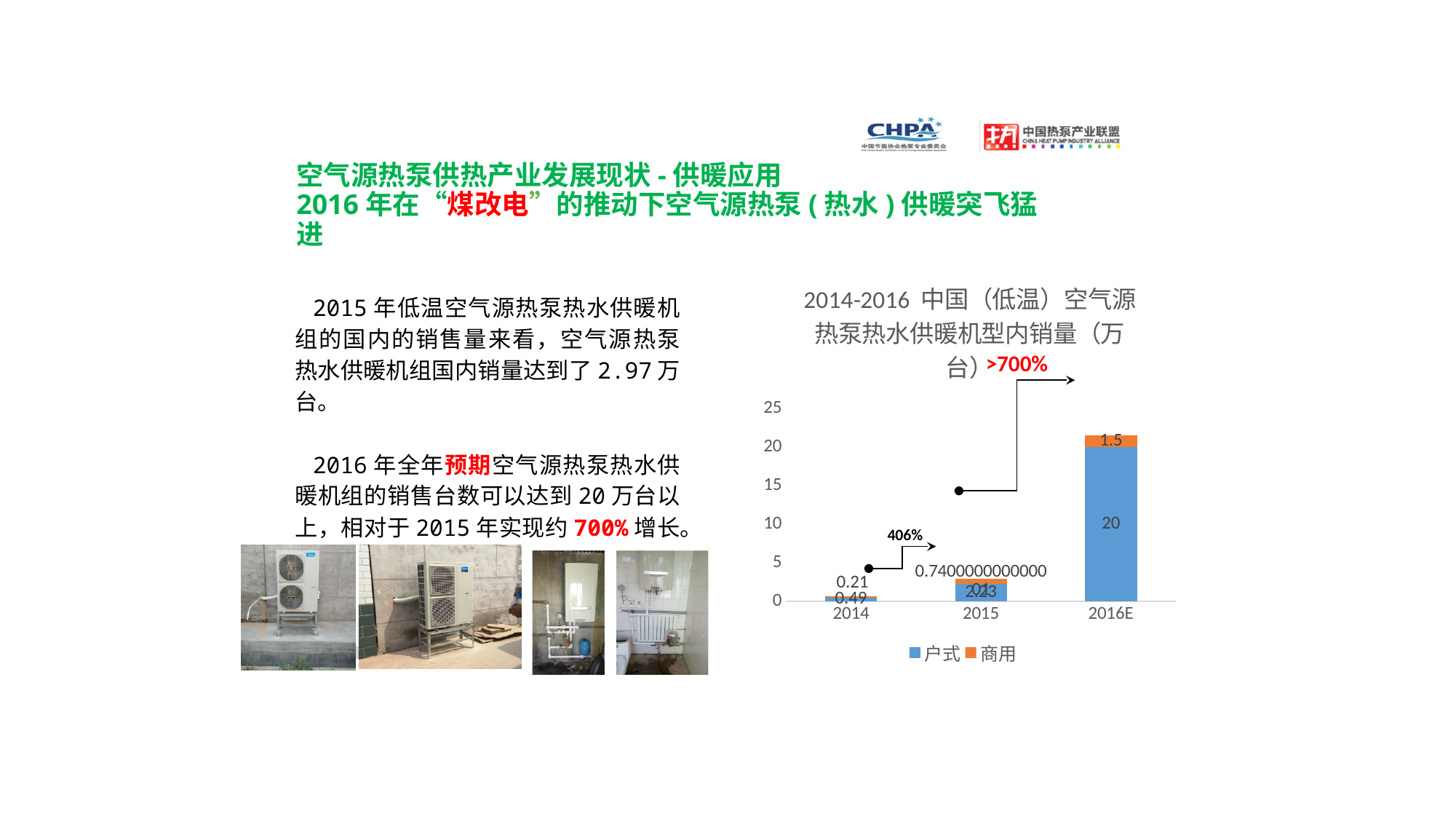
How many series does the chart legend list? 2 What is the value of 户式 for 2014? 0.49 What is the total of the stacked bar for 2016E? 21.5 What is the value of 商用 for 2016E? 1.5 What is the value of 户式 for 2016E? 20 Which year has the highest 户式 value? 2016E What is the difference between 户式 and 商用 in 2014? 0.28 How many years (categories) are shown on the x axis of the chart? 3 What is the value of 商用 for 2014? 0.21 For 2016E, which is larger, 户式 or 商用? 户式 What type of chart is shown on the slide? bar chart What growth percentage is annotated between 2015 and 2016E on the chart? >700%